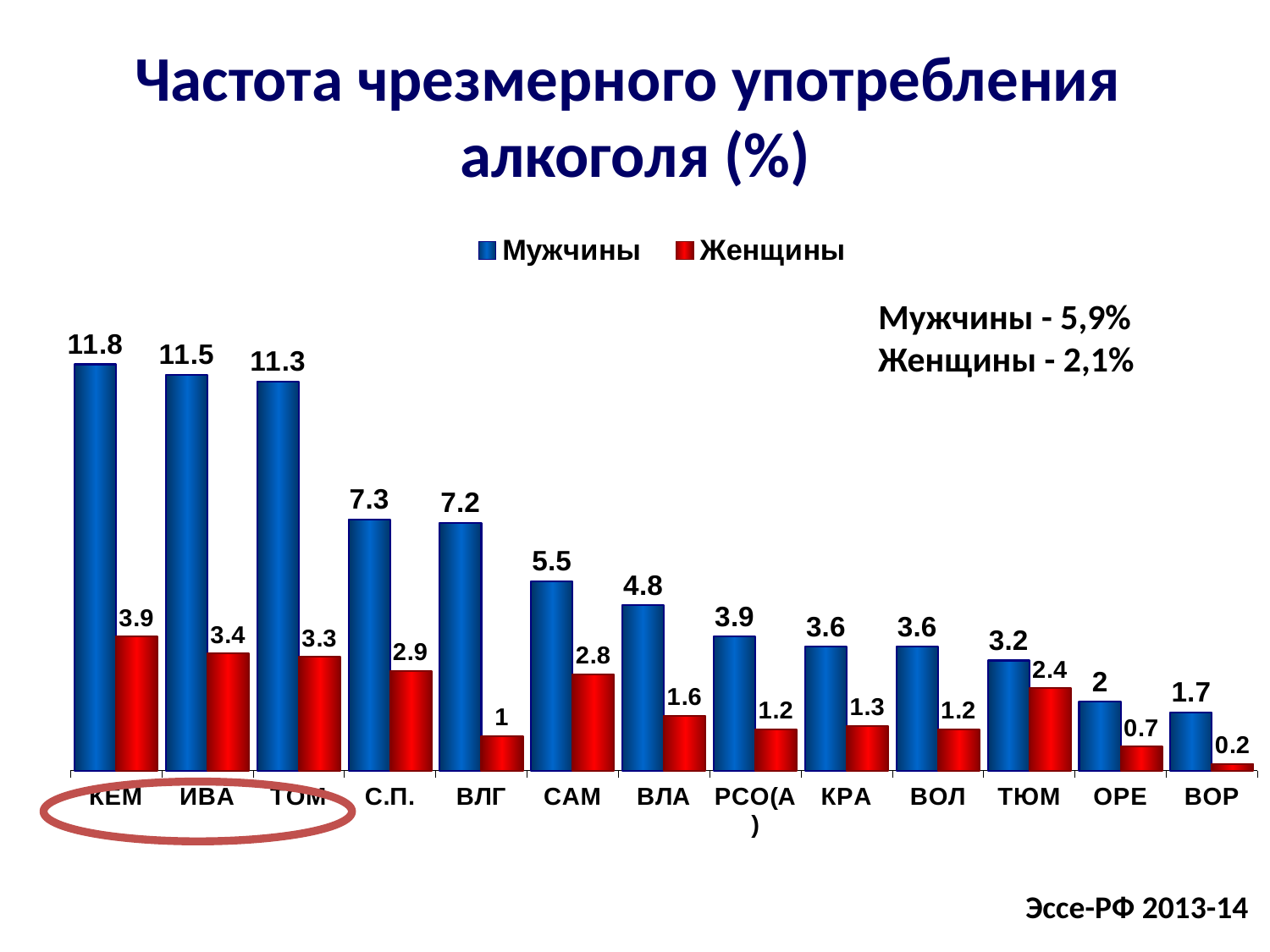
How many series does the legend list? 2 Which category has the lowest value for Женщины? ВОР How many categories are shown on the x axis? 13 Which is larger: the Женщины value in ТЮМ or the Женщины value in ВЛА? ТЮМ What is the value for Женщины in ВЛГ? 1 Which category has the highest value for Мужчины? КЕМ What kind of chart is shown on the slide? Bar chart What is the value for Женщины in С.П.? 2.9 What is the difference between the Мужчины and Женщины values in САМ? 2.7 What is the value for Мужчины in КЕМ? 11.8 Do the Мужчины values rise or fall from left to right along the x axis? Fall What colour are the bars for the Женщины series? Red